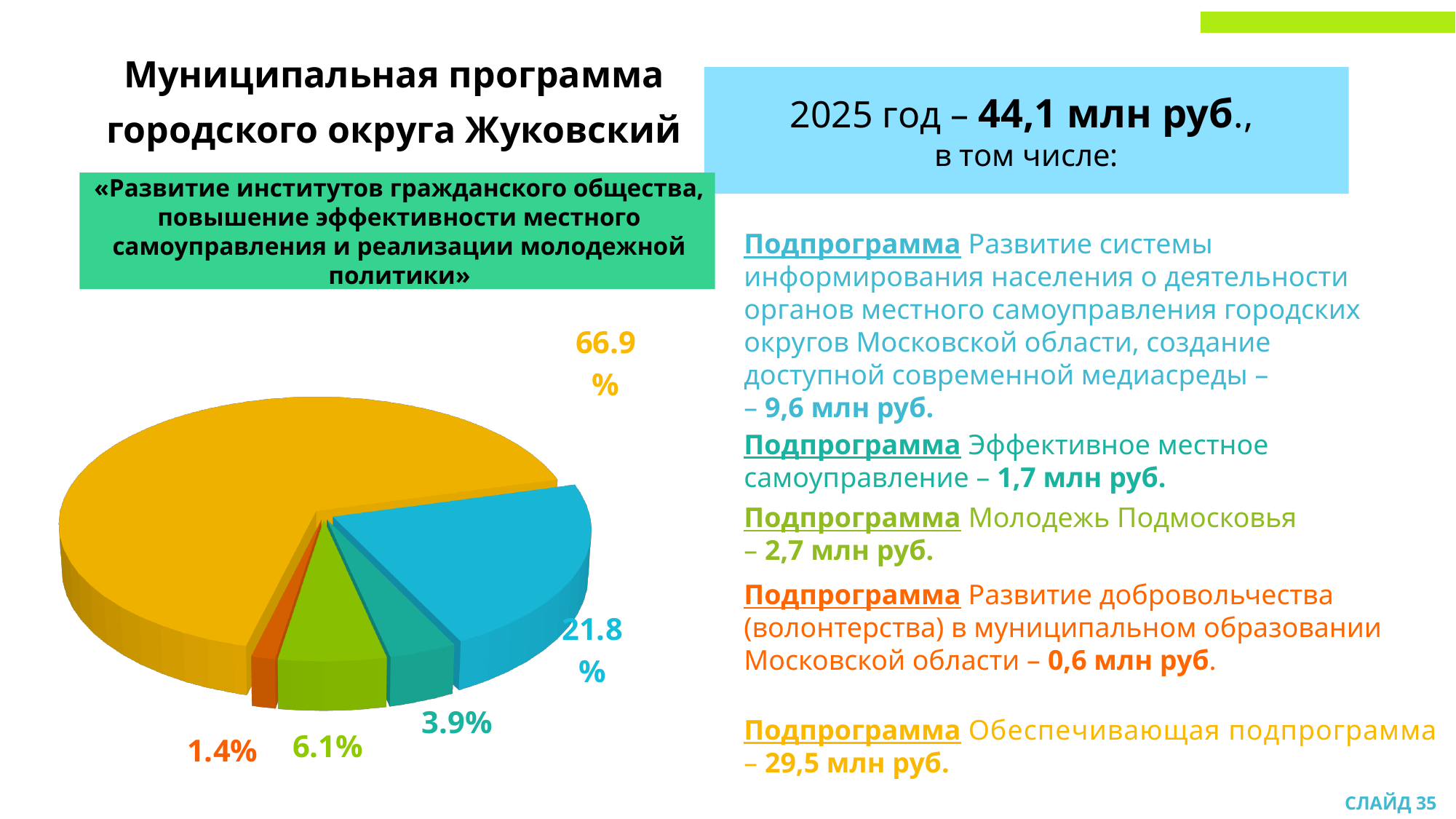
What is the difference between the largest slice (66.9%) and the blue slice (21.8%) in the pie chart? 45.1% What percentage is labelled on the teal slice of the pie chart? 3.9% What is the smallest share shown on the pie chart? 1.4% How many slices does the pie chart have? 5 What kind of chart is shown on the slide? pie chart What colour is the largest slice of the pie chart? yellow What is the largest share shown on the pie chart? 66.9% What percentage is labelled on the orange slice of the pie chart? 1.4% What percentage is labelled on the blue slice of the pie chart? 21.8% Which is larger in the pie chart: the green slice (6.1%) or the teal slice (3.9%)? the green slice (6.1%) What is the combined share of the green (6.1%) and orange (1.4%) slices in the pie chart? 7.5% What percentage is labelled on the green slice of the pie chart? 6.1%